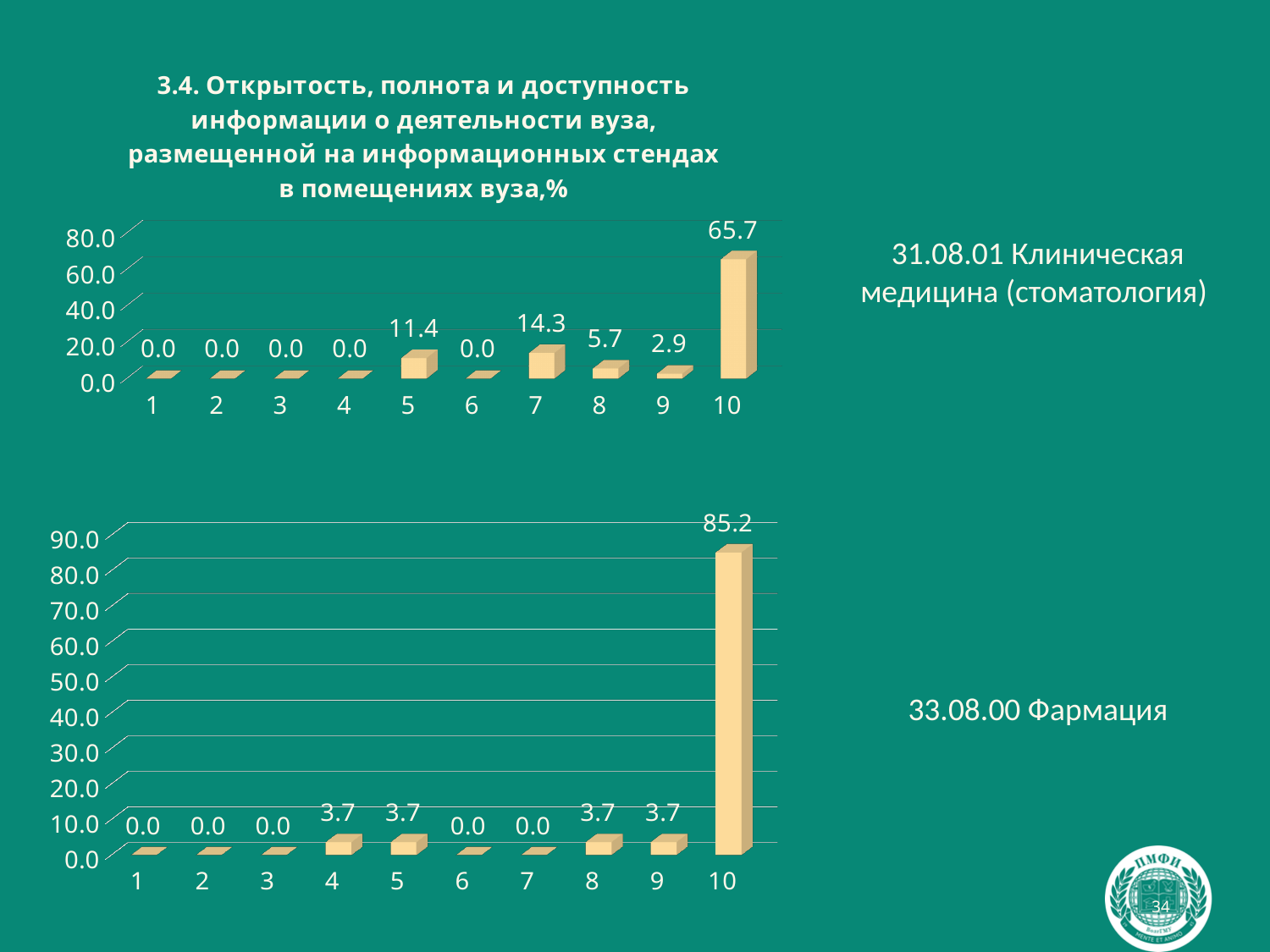
In the bottom chart (33.08.00 Фармация), what is the value for category 4? 3.7 In the top chart (31.08.01 Клиническая медицина (стоматология)), how many categories are shown on the x axis? 10 In the bottom chart (33.08.00 Фармация), how many categories have a value of 0.0? 5 In the top chart (31.08.01 Клиническая медицина (стоматология)), what is the value for category 7? 14.3 In the top chart (31.08.01 Клиническая медицина (стоматология)), what is the value for category 10? 65.7 In the top chart (31.08.01 Клиническая медицина (стоматология)), which category has the highest value? 10 In the bottom chart (33.08.00 Фармация), what is the difference between the values for category 10 and category 9? 81.5 In the top chart (31.08.01 Клиническая медицина (стоматология)), which is larger, the value for category 8 or category 9? category 8 What type of chart is the bottom chart (33.08.00 Фармация)? bar chart In the top chart (31.08.01 Клиническая медицина (стоматология)), what is the difference between the values for category 7 and category 5? 2.9 In the bottom chart (33.08.00 Фармация), which category has the highest value? 10 In the bottom chart (33.08.00 Фармация), what is the value for category 10? 85.2